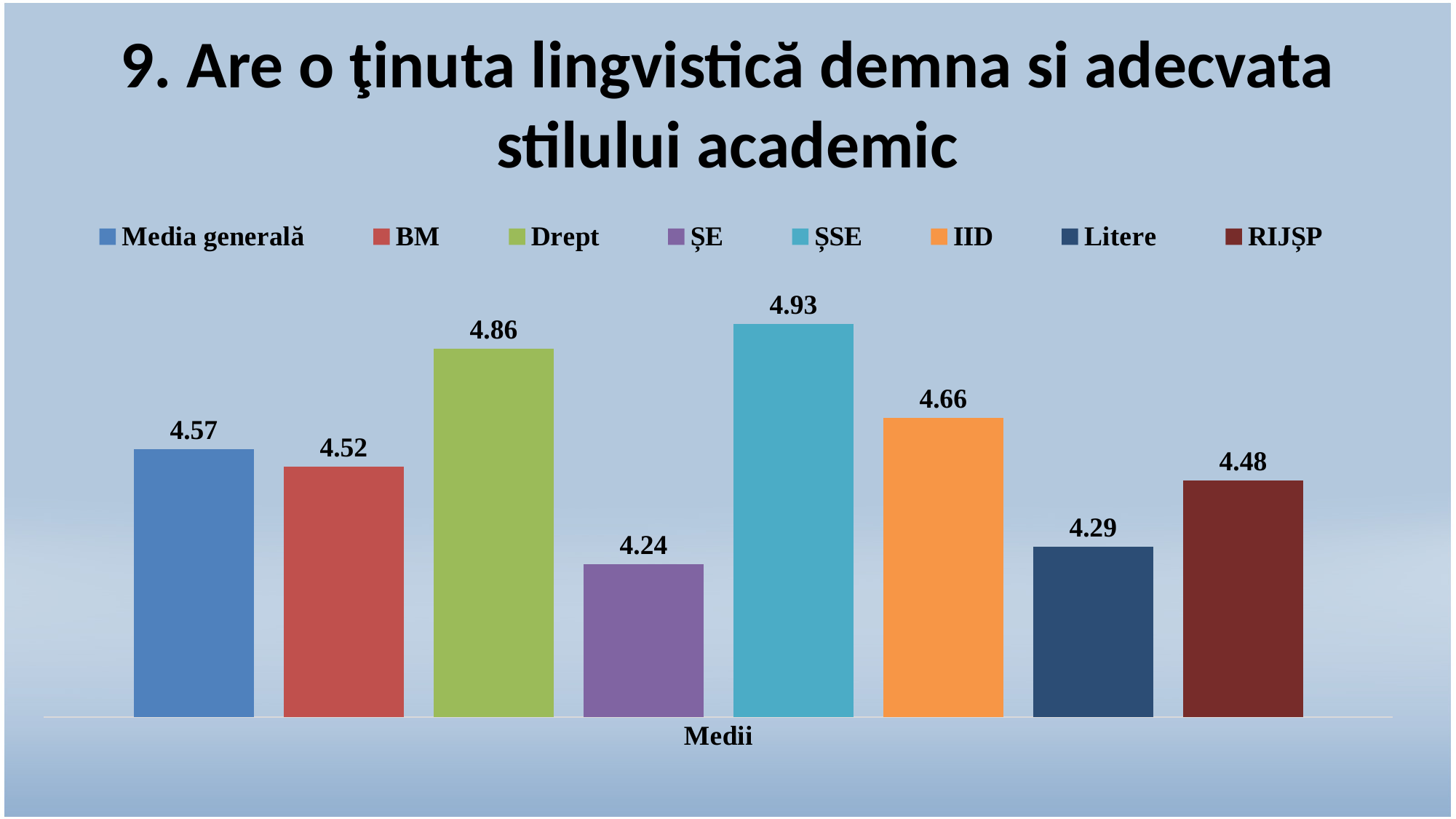
What is the difference between the values for Drept and ȘE? 0.62 How many series does the legend list? 8 What is the label on the x axis? Medii Which series has the highest value? ȘSE What kind of chart is shown? bar chart Which is larger, the value for IID or the value for BM? IID What is the value for Media generală? 4.57 What is the value for Litere? 4.29 What is the value for ȘSE? 4.93 What is the difference between the values for ȘSE and Litere? 0.64 What is the value for RIJȘP? 4.48 Which series has the lowest value? ȘE